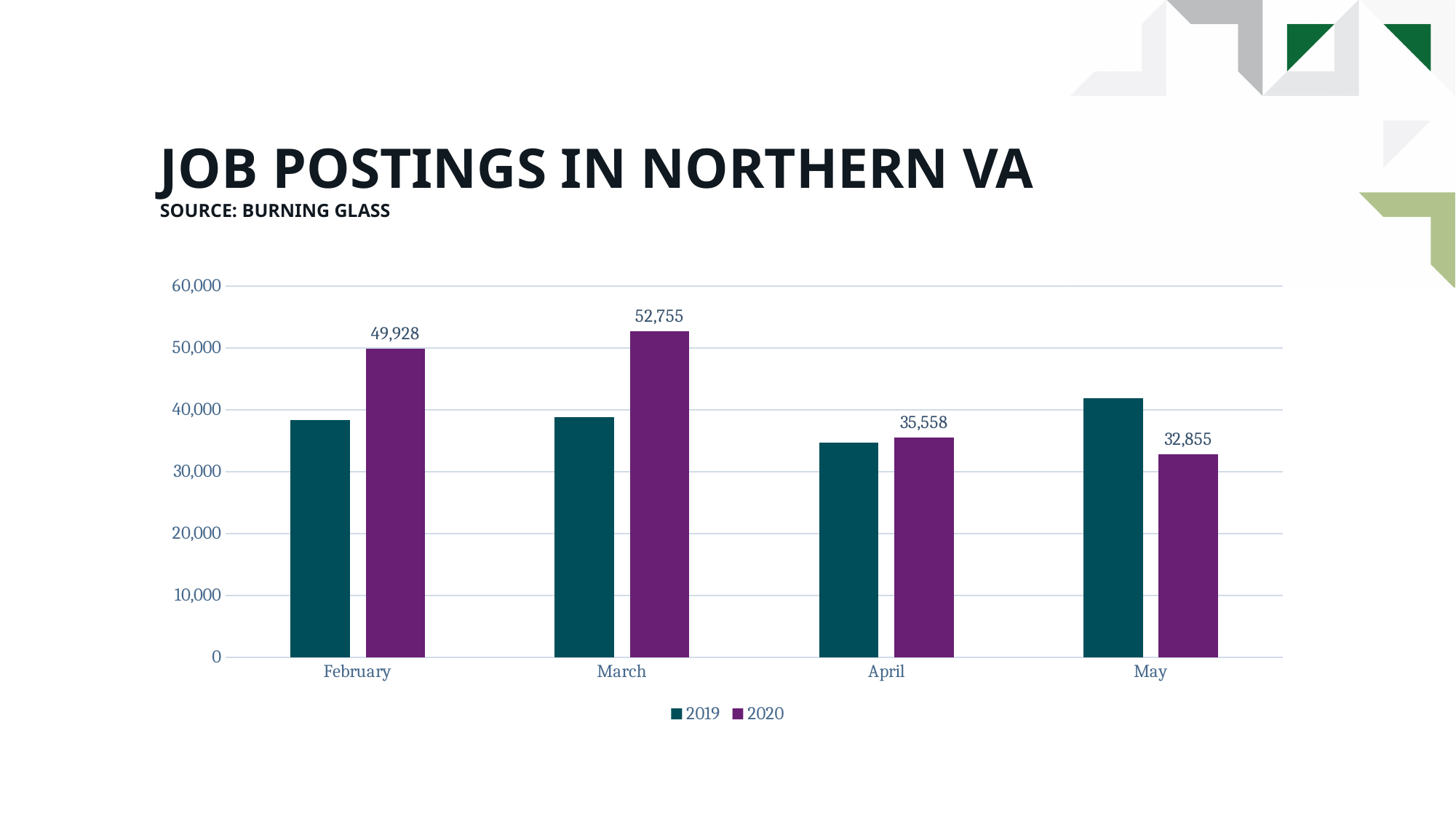
What is the difference between the 2020 values for March and February? 2,827 What is the value for 2020 in March? 52,755 Which month has the lowest value for 2020? May Is the value for 2019 in May greater or less than 40,000? greater Which is larger in May, the value for 2019 or the value for 2020? 2019 How many months are shown on the x axis? 4 Which month has the highest value for 2020? March What is the value for 2020 in May? 32,855 How many series does the legend list? 2 What is the value for 2020 in February? 49,928 Is the value for 2019 in April greater or less than 40,000? less What kind of chart is shown on the slide? bar chart